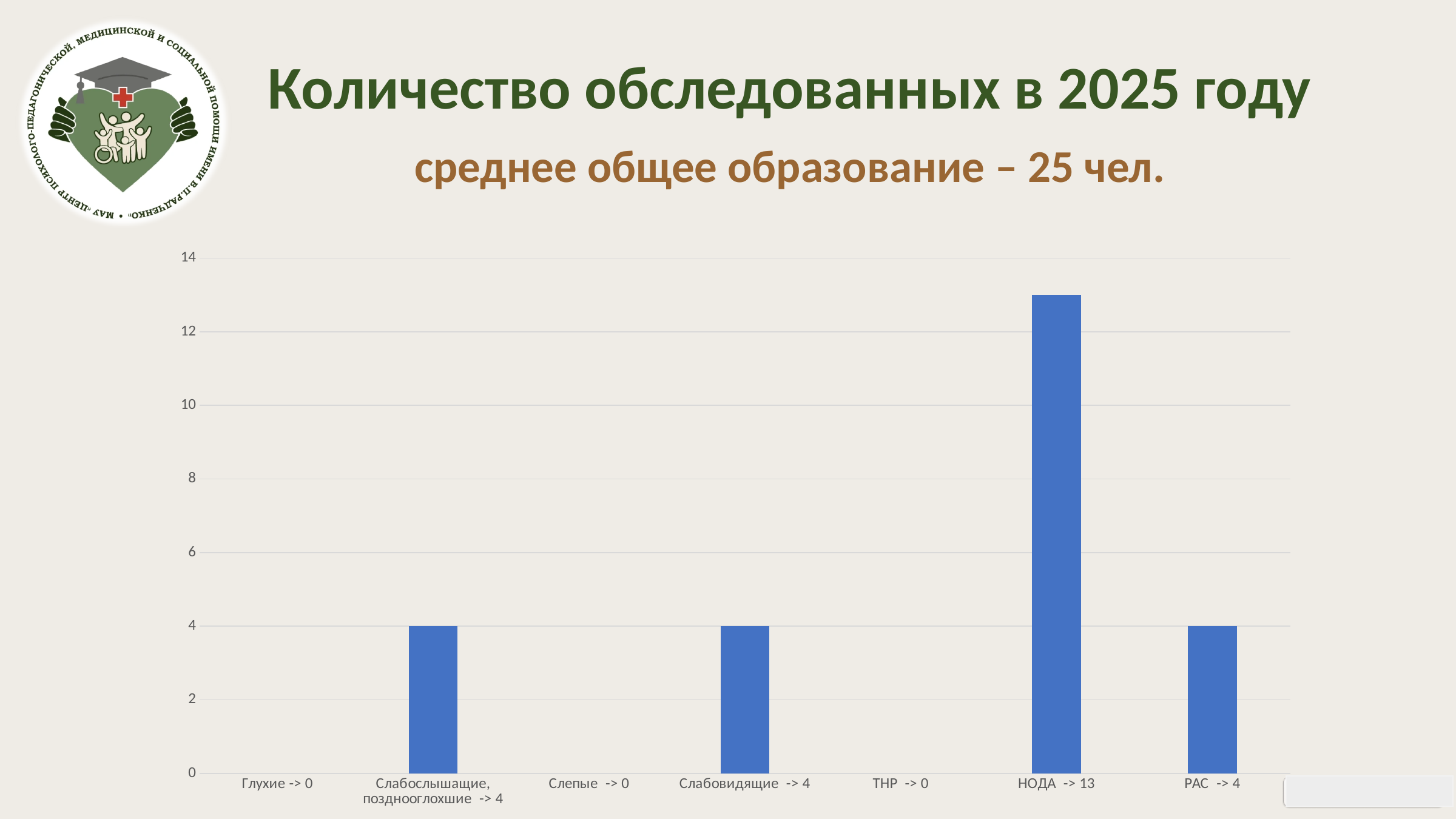
Which category has the highest value? НОДА What is the value for НОДА? 13 What is the value for Глухие? 0 How many categories are shown on the x axis? 7 How many categories have a value of 0? 3 Which is larger, the value for НОДА or the value for Слабослышащие, позднооглохшие? НОДА What kind of chart is shown on the slide? bar chart Is the value for НОДА greater or less than 12? greater What is the difference between the values for НОДА and РАС? 9 What is the value for Слабовидящие? 4 What is the value for РАС? 4 What is the title of the slide above the chart? Количество обследованных в 2025 году